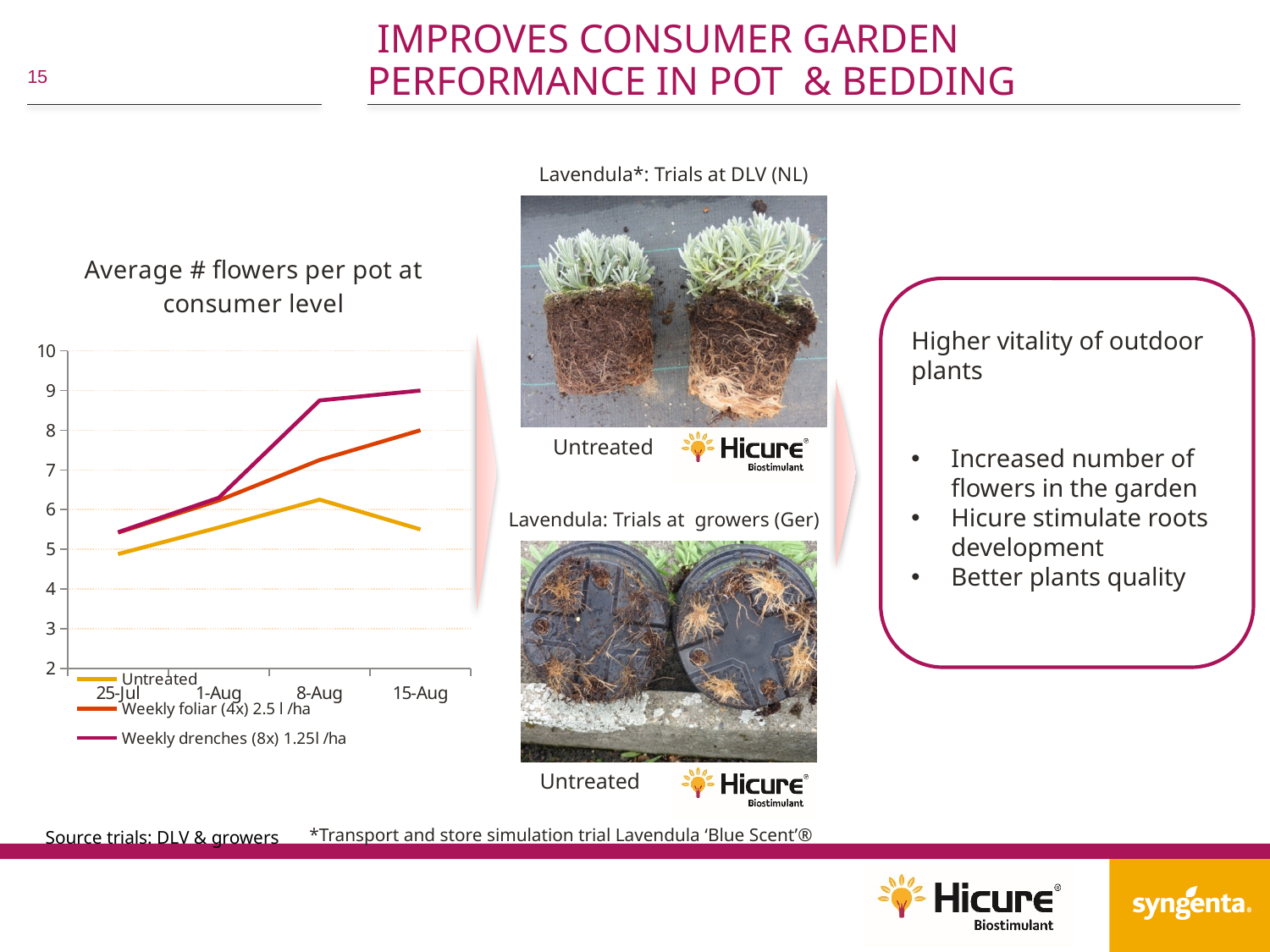
At 8-Aug, which is larger: Weekly drenches (8x) 1.25l /ha or Weekly foliar (4x) 2.5 l /ha? Weekly drenches (8x) 1.25l /ha What is the title of the chart? Average # flowers per pot at consumer level How many series does the chart's legend list? 3 Which series has the lowest value at 15-Aug? Untreated Is the value for Weekly drenches (8x) 1.25l /ha at 8-Aug greater or less than 8? greater Does the Untreated series rise or fall between 8-Aug and 15-Aug? fall Does the Weekly drenches (8x) 1.25l /ha series rise or fall from 25-Jul to 15-Aug? rise Which series has the highest value at 15-Aug? Weekly drenches (8x) 1.25l /ha What kind of chart is shown on the slide? line chart Is the value for Untreated at 25-Jul greater or less than 6? less What is the value for Weekly foliar (4x) 2.5 l /ha at 15-Aug? 8 How many dates are shown along the x axis of the chart? 4